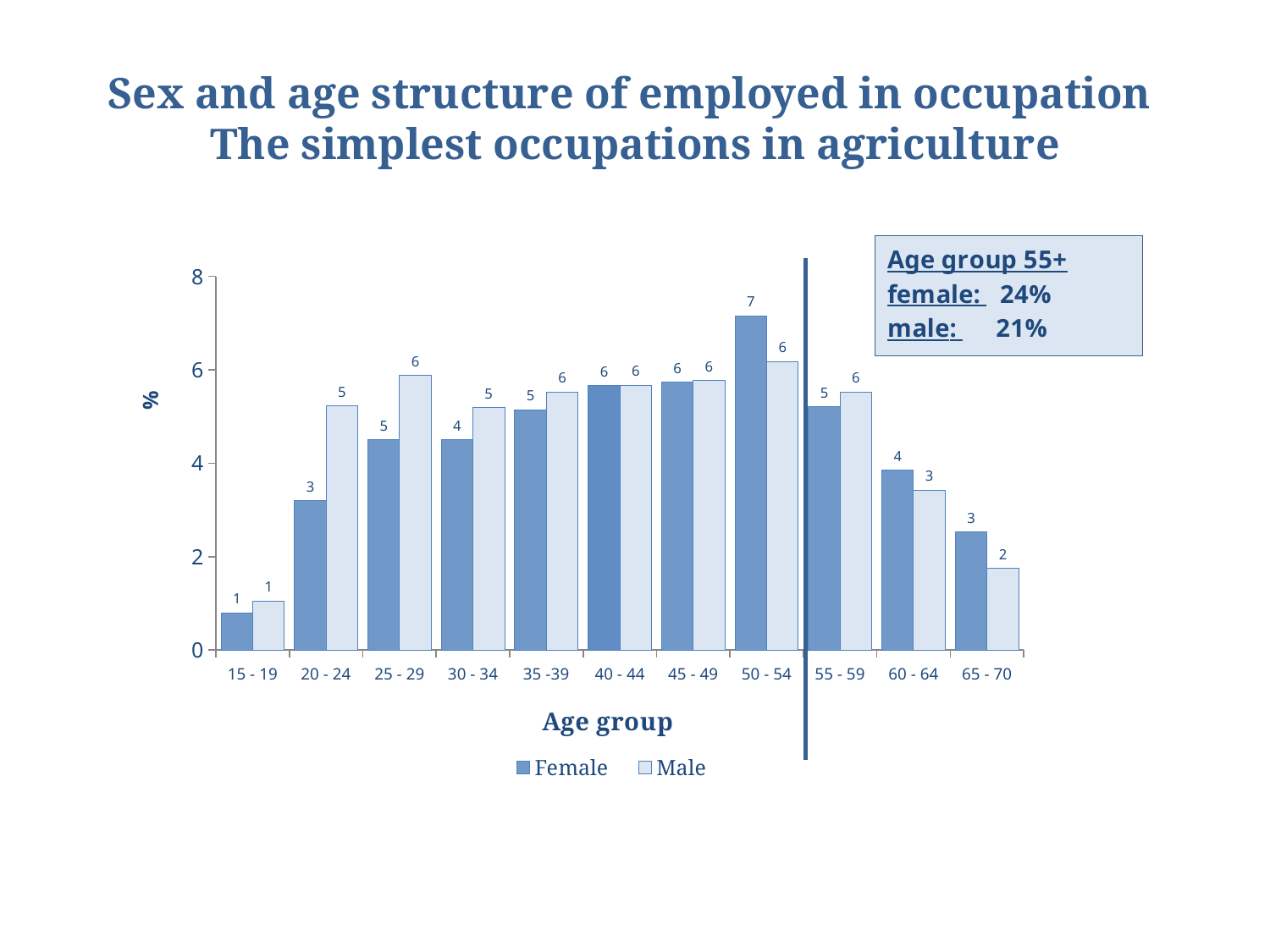
Is the Female value for the 50 - 54 age group greater or less than 6? greater What kind of chart is shown on the slide? bar chart How many age groups are shown on the x axis? 11 What is the Male value for the 20 - 24 age group? 5 Which age group has the lowest Male value? 15 - 19 For the 25 - 29 age group, is the Female or the Male value larger? Male How many series does the legend list? 2 What is the Female value for the 50 - 54 age group? 7 Which age group has the highest Female value? 50 - 54 Do the Female values rise or fall from the 50 - 54 age group to the 65 - 70 age group? fall What is the difference between the Male and Female values for the 20 - 24 age group? 2 For the 60 - 64 age group, is the Female or the Male value larger? Female